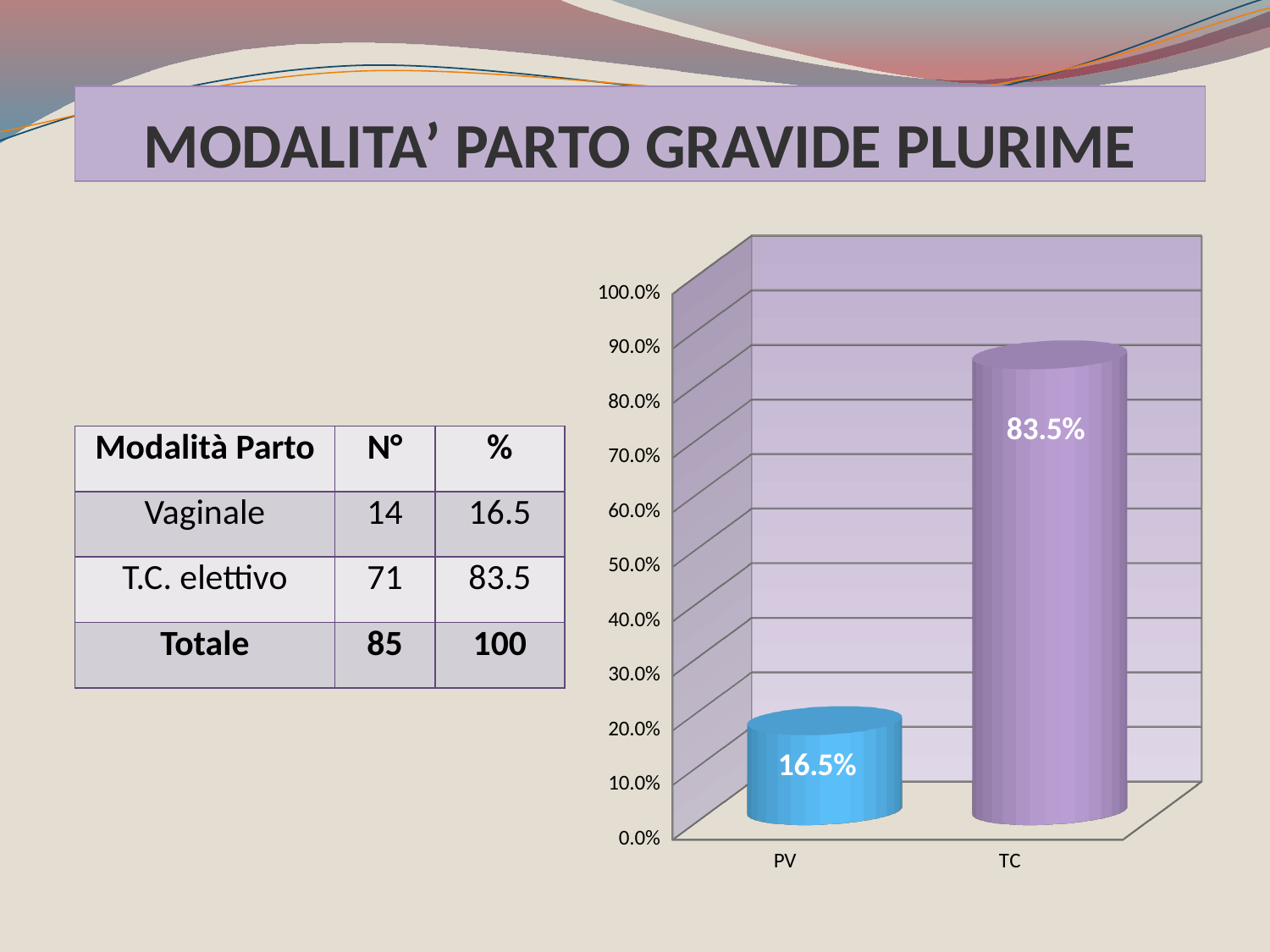
What is the difference between the values for TC and PV? 67.0% Which is larger, the value for PV or the value for TC? TC Which category has the highest value in the chart? TC What kind of chart is shown on the slide? bar chart What is the value for PV in the chart? 16.5% What colour is the bar for PV? blue What is the highest value shown on the chart's y axis? 100.0% How many categories are shown on the x axis of the chart? 2 Is the value for TC greater or less than 80%? greater What is the value for TC in the chart? 83.5% Which category has the lowest value in the chart? PV Is the value for PV greater or less than 20%? less